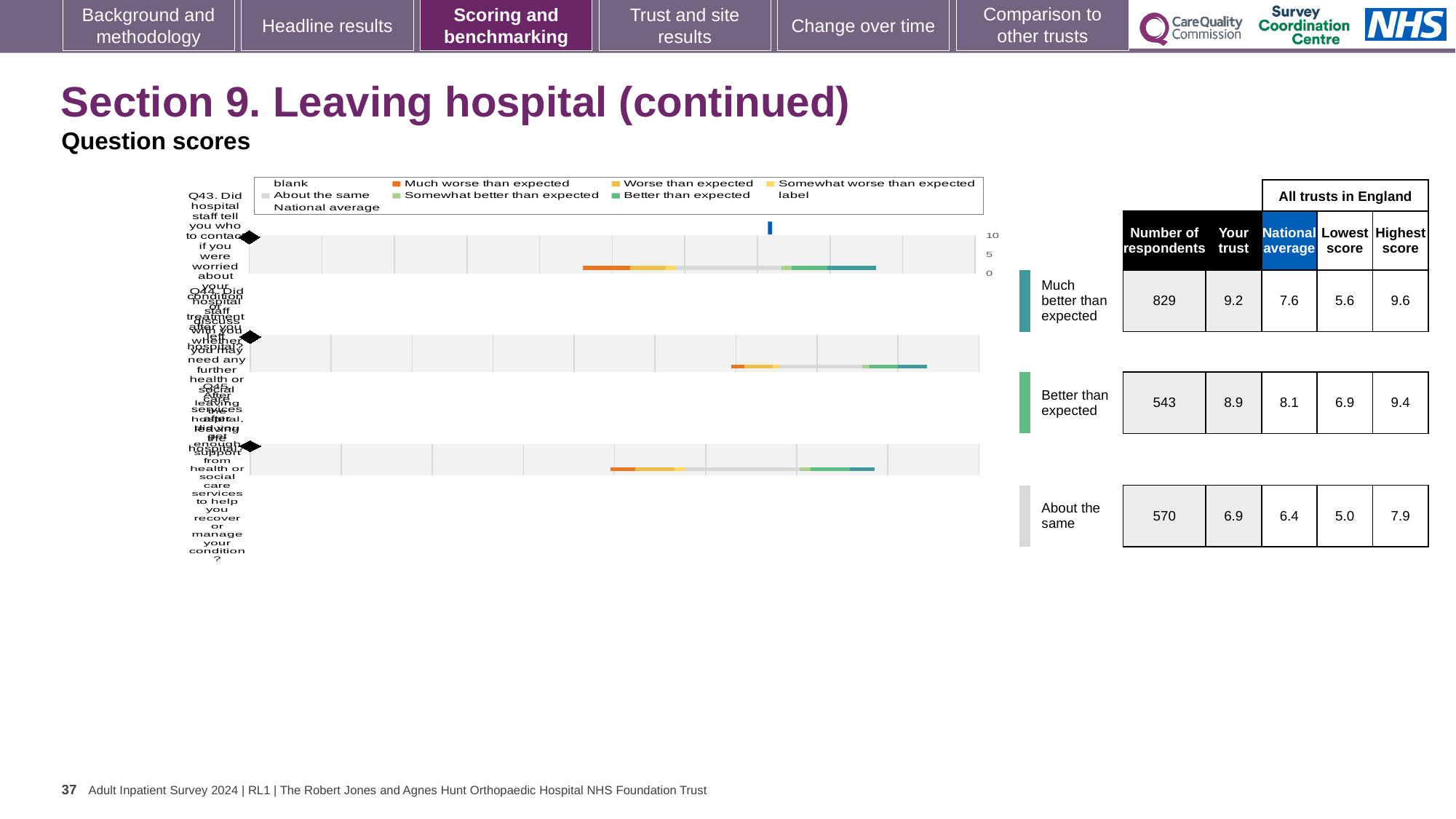
Which question row has the highest 'Your trust' score? Q43 What is the benchmark category shown for the third question row (Q45)? About the same What is the highest score across all trusts in England for the first question row (Q43)? 9.6 What is the difference between the 'Your trust' score and the national average for the first question row (Q43)? 1.6 What is the national average for the second question row (Q44)? 8.1 What is the 'Your trust' score for the first question row (Q43)? 9.2 What kind of chart is shown on the slide? bar chart What is the lowest score across all trusts in England for the third question row (Q45)? 5.0 How many respondents are recorded for the third question row (Q45)? 570 Is the 'Your trust' score for the second question row (Q44) larger than its national average? Yes Which question row has the lowest 'Your trust' score? Q45 How many questions (categories) are plotted in the chart? 3